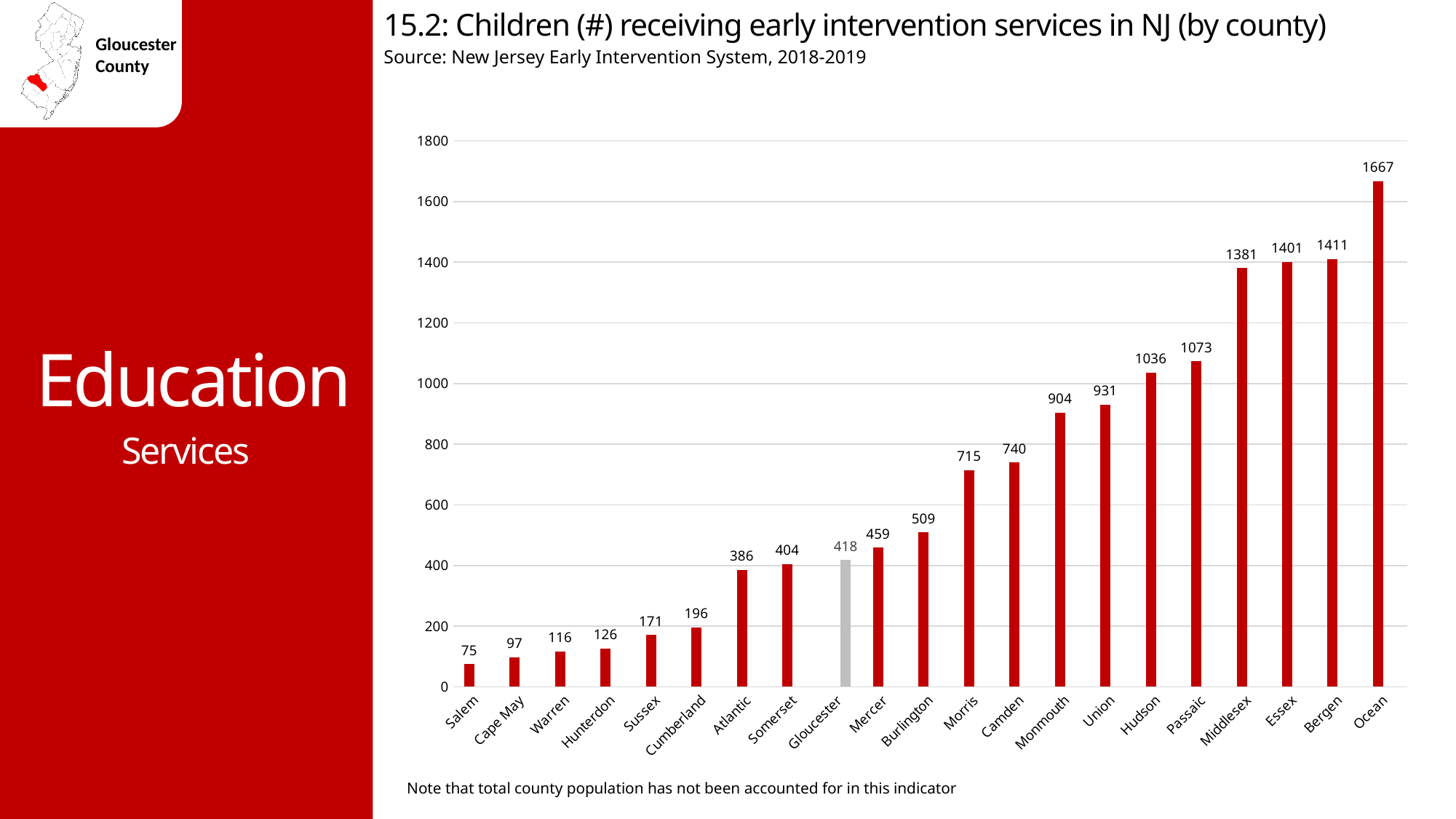
Which county has the lowest number of children receiving early intervention services? Salem How many children received early intervention services in Gloucester County? 418 How many counties are shown on the chart? 21 What is the difference between the values for Gloucester and Salem? 343 What is the difference between the values for Ocean and Bergen? 256 What is the value shown for Camden? 740 Which county has the highest number of children receiving early intervention services? Ocean Which county's bar is shown in grey instead of red? Gloucester What type of chart is shown on the slide? Bar chart Which county has a larger value, Mercer or Somerset? Mercer Do the values rise or fall from left to right along the x axis? Rise Is the value for Hudson greater or less than 1000? greater